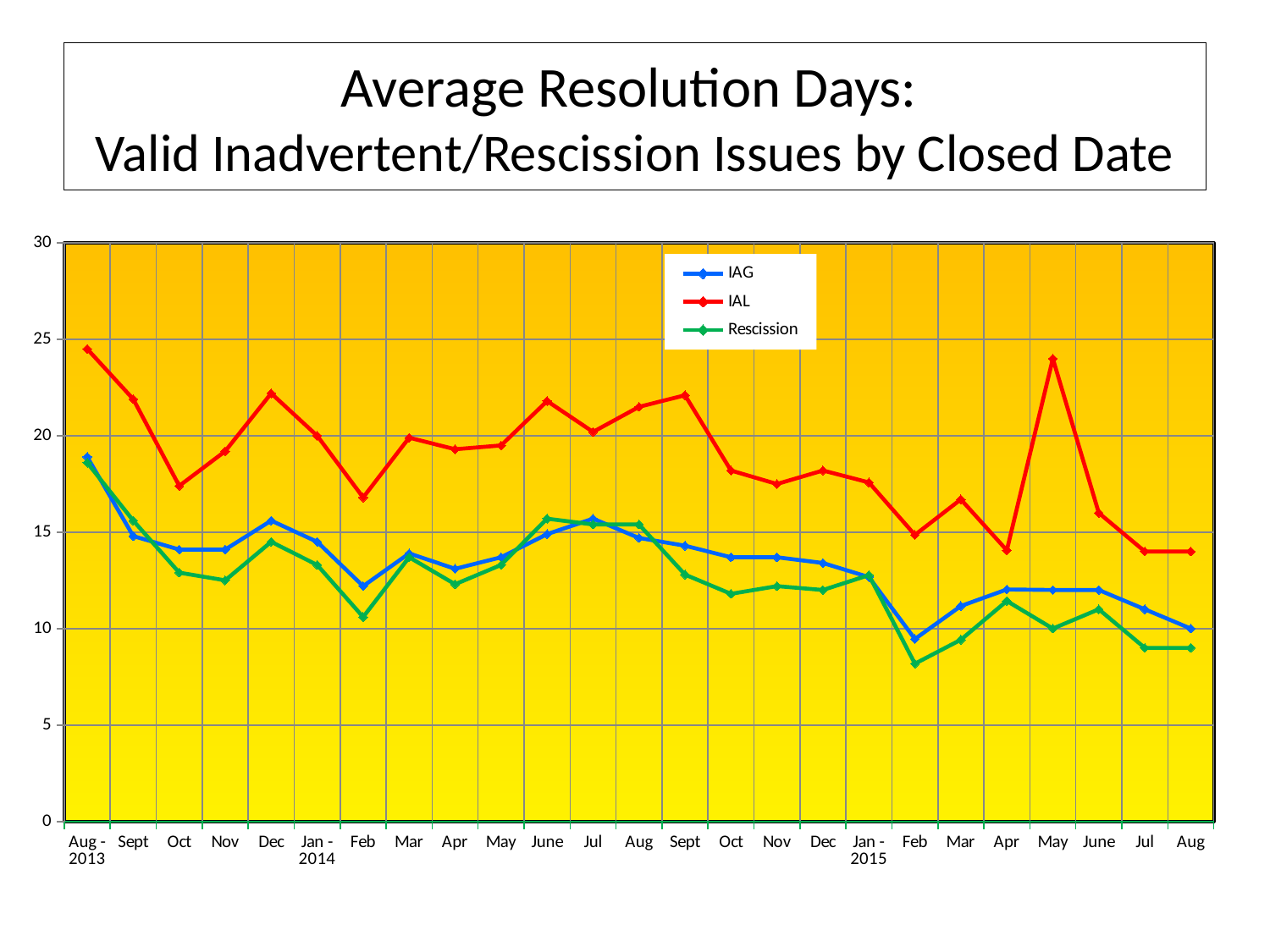
Is the IAL value for Aug 2015 greater or less than 15? less Does the IAG series rise or fall from Jan 2015 to Feb 2015? fall Which series has the higher value in Aug 2013, IAL or IAG? IAL How many series does the legend list? 3 Is the Rescission value for Feb 2015 greater or less than 10? less How many months are plotted along the x axis? 25 What kind of chart is shown on the slide? line chart Is the IAL value for May 2015 greater or less than 20? greater Which series is drawn in red? IAL In which month does the Rescission series reach its lowest value? Feb 2015